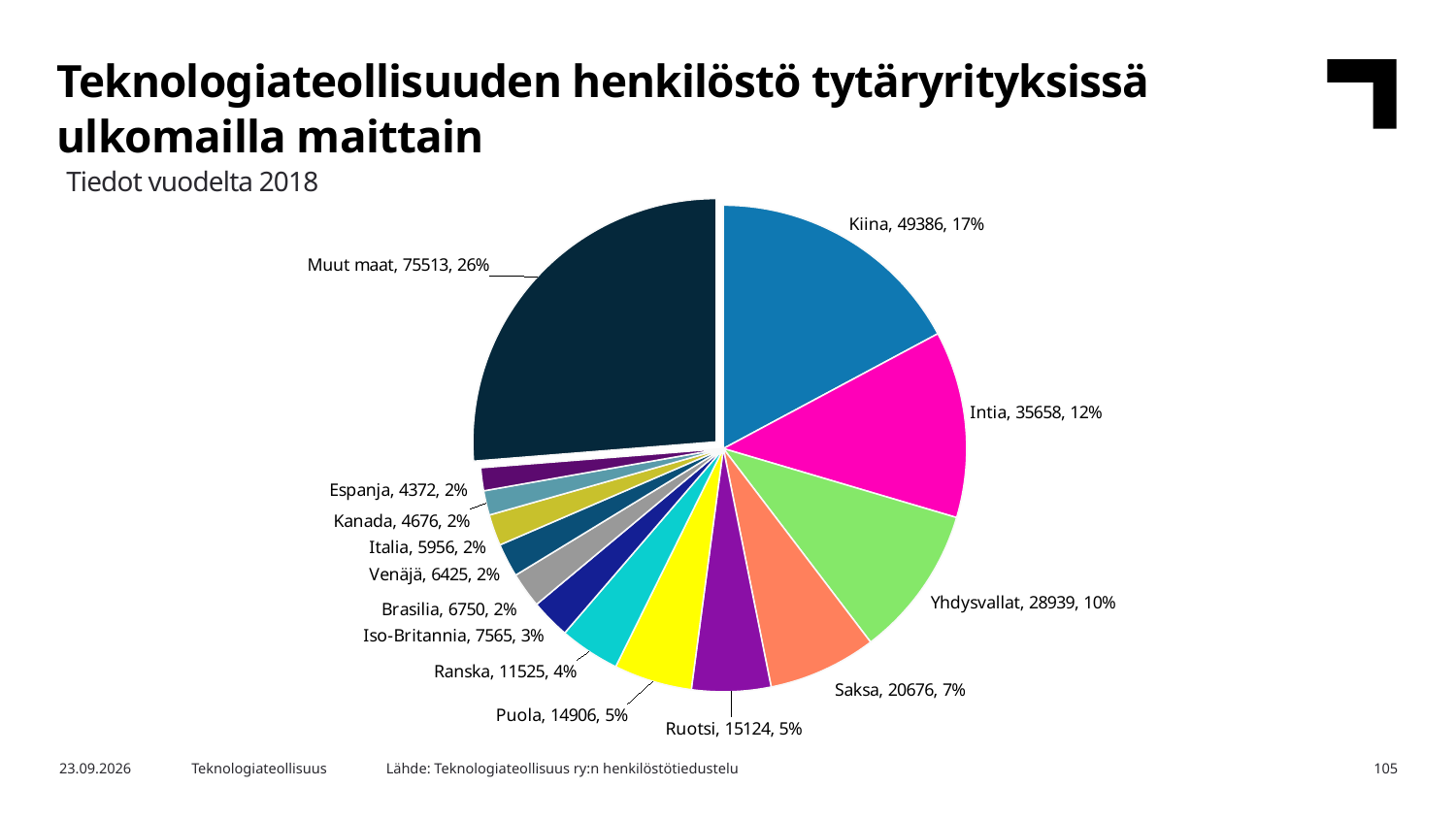
What is the value shown for Yhdysvallat? 28939 What kind of chart is shown on the slide? pie chart What percentage share is shown for Muut maat? 26% How many slices does the pie chart have? 14 What is the difference between the values for Kiina and Intia? 13728 What percentage share is shown for Intia? 12% Which named slice has the smallest value? Espanja What is the value shown for Kiina? 49386 Which is larger, the value for Saksa or the value for Ruotsi? Saksa Which slice has the largest share of the pie? Muut maat What is the title of the chart on the slide? Teknologiateollisuuden henkilöstö tytäryrityksissä ulkomailla maittain What is the value shown for Iso-Britannia? 7565